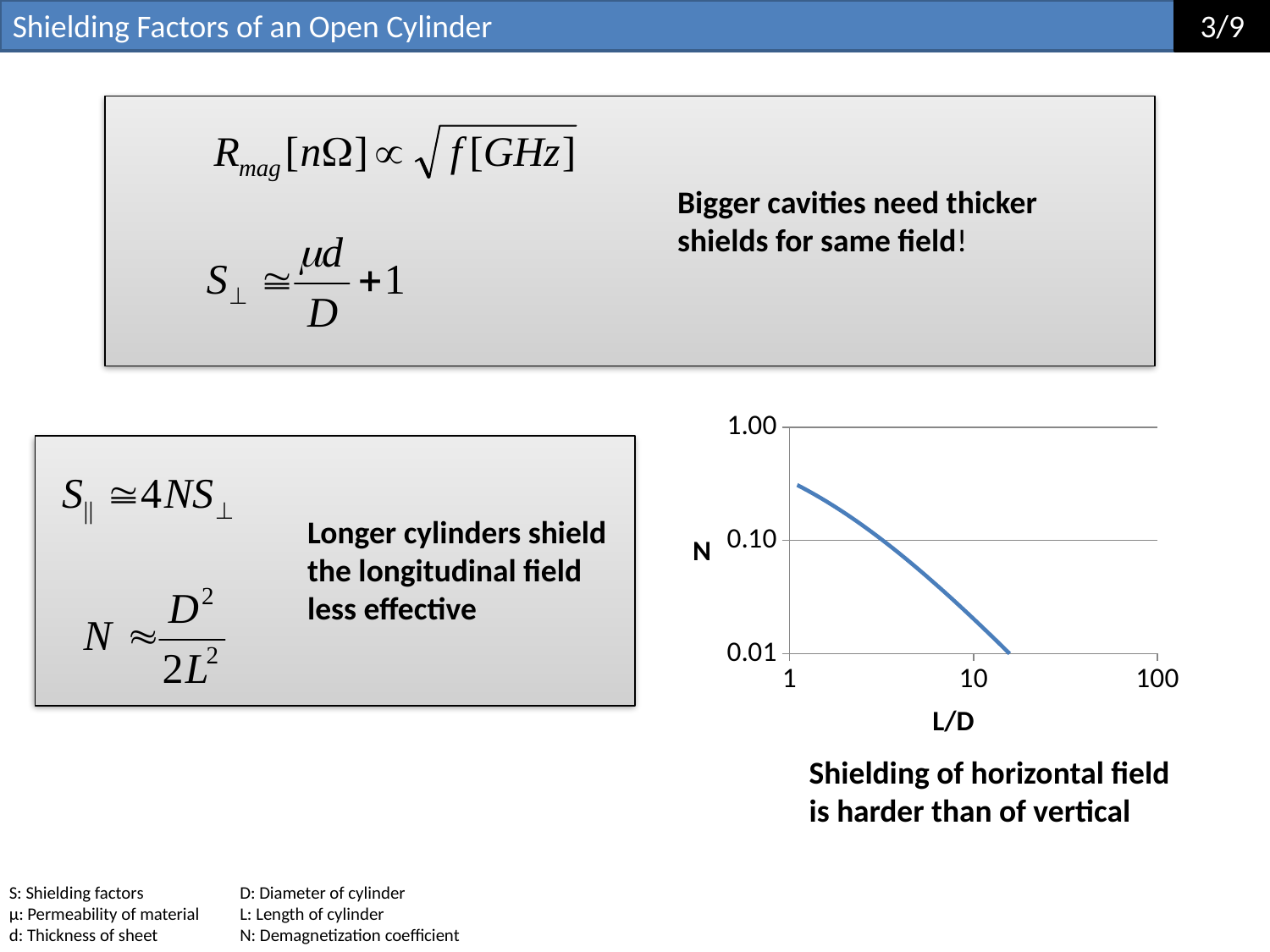
What is the label of the x axis of the chart? L/D Does the value of N rise or fall as L/D increases along the x axis? fall How many lines are plotted on the chart? 1 What kind of chart is shown on the slide? line chart Is the value of N at L/D = 10 greater or less than 0.10? less What is the highest tick value shown on the x axis of the chart? 100 Is the value of N at L/D = 1 greater or less than 0.10? greater What is the label of the y axis of the chart? N Is the value of N at L/D = 1 greater or less than 1.00? less